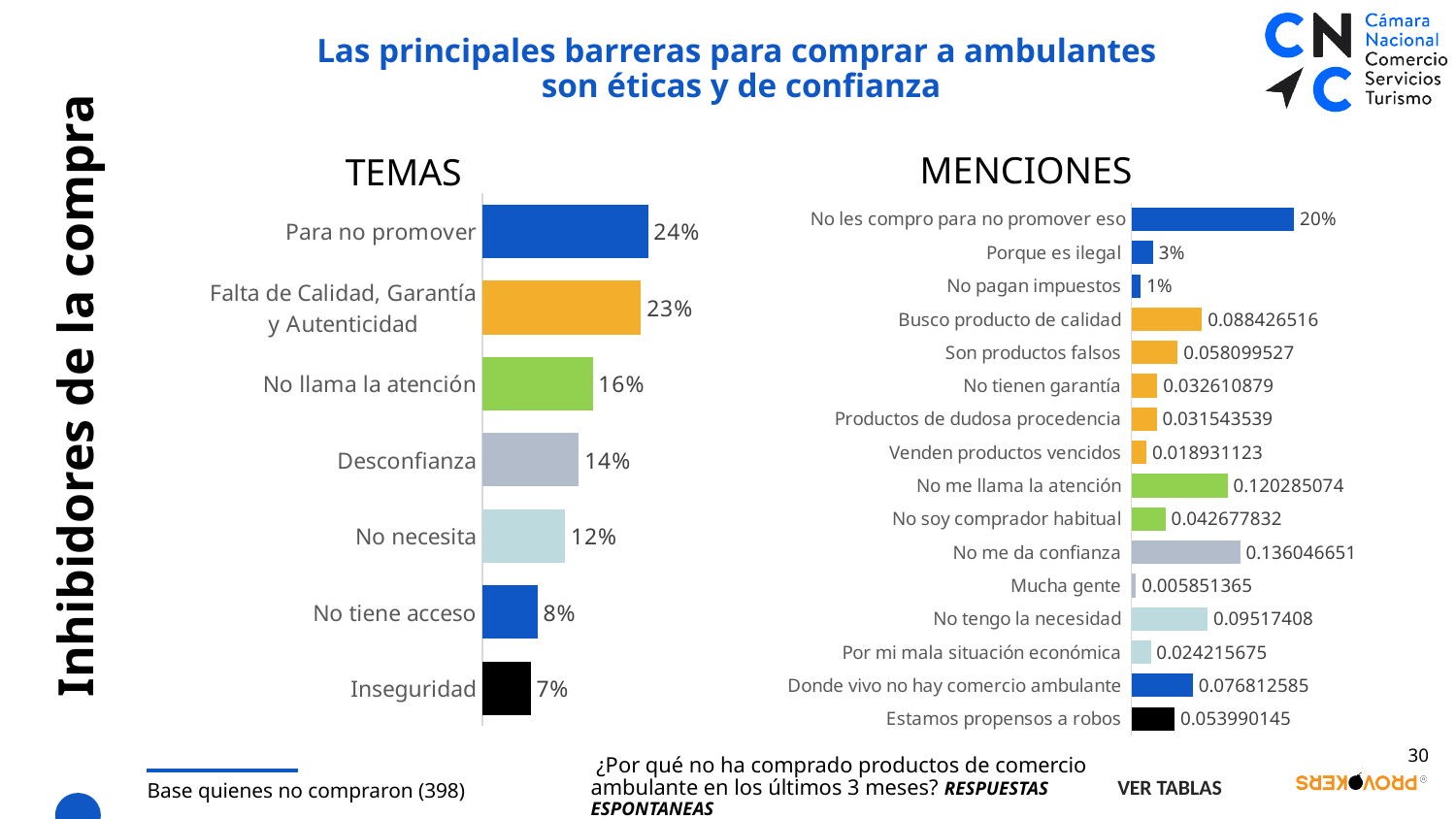
In the MENCIONES chart, how many categories are shown? 16 What type of chart is the TEMAS chart? Bar chart In the TEMAS chart, what is the difference between No llama la atención and No necesita? 4% In the MENCIONES chart, which category has the highest value? No les compro para no promover eso In the MENCIONES chart, what is the value for No me da confianza? 0.136046651 In the TEMAS chart, which category has the lowest value? Inseguridad In the TEMAS chart, which is larger: No tiene acceso or Inseguridad? No tiene acceso In the TEMAS chart, what is the value for Desconfianza? 14% In the MENCIONES chart, what is the value for No les compro para no promover eso? 20% In the TEMAS chart, what is the value for Para no promover? 24% In the MENCIONES chart, what is the value for Mucha gente? 0.005851365 In the TEMAS chart, how many categories are shown? 7